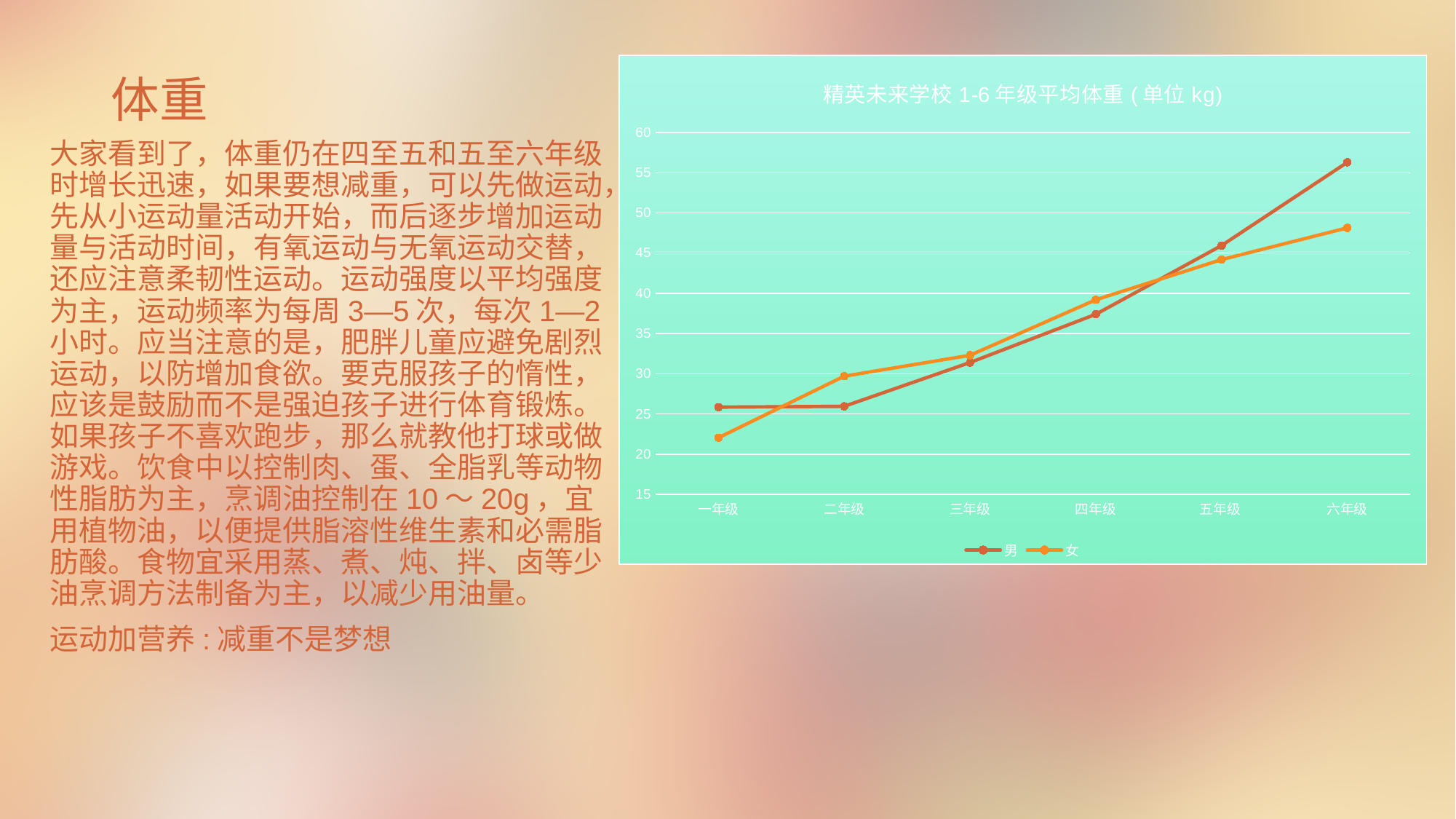
Which series is drawn in the lighter orange line? 女 Is the value for 女 at 六年级 greater or less than 50? less Do the values for 男 rise or fall from 一年级 to 六年级? rise What is the title of the chart? 精英未来学校 1-6 年级平均体重 ( 单位 kg) At 六年级, which series has the larger value, 男 or 女? 男 How many series does the legend list? 2 What kind of chart is shown on the slide? line chart How many grade categories are plotted along the x axis? 6 At which grade is the value for 男 highest? 六年级 At 二年级, which series has the larger value, 男 or 女? 女 At which grade is the value for 女 lowest? 一年级 Is the value for 男 at 六年级 greater or less than 55? greater